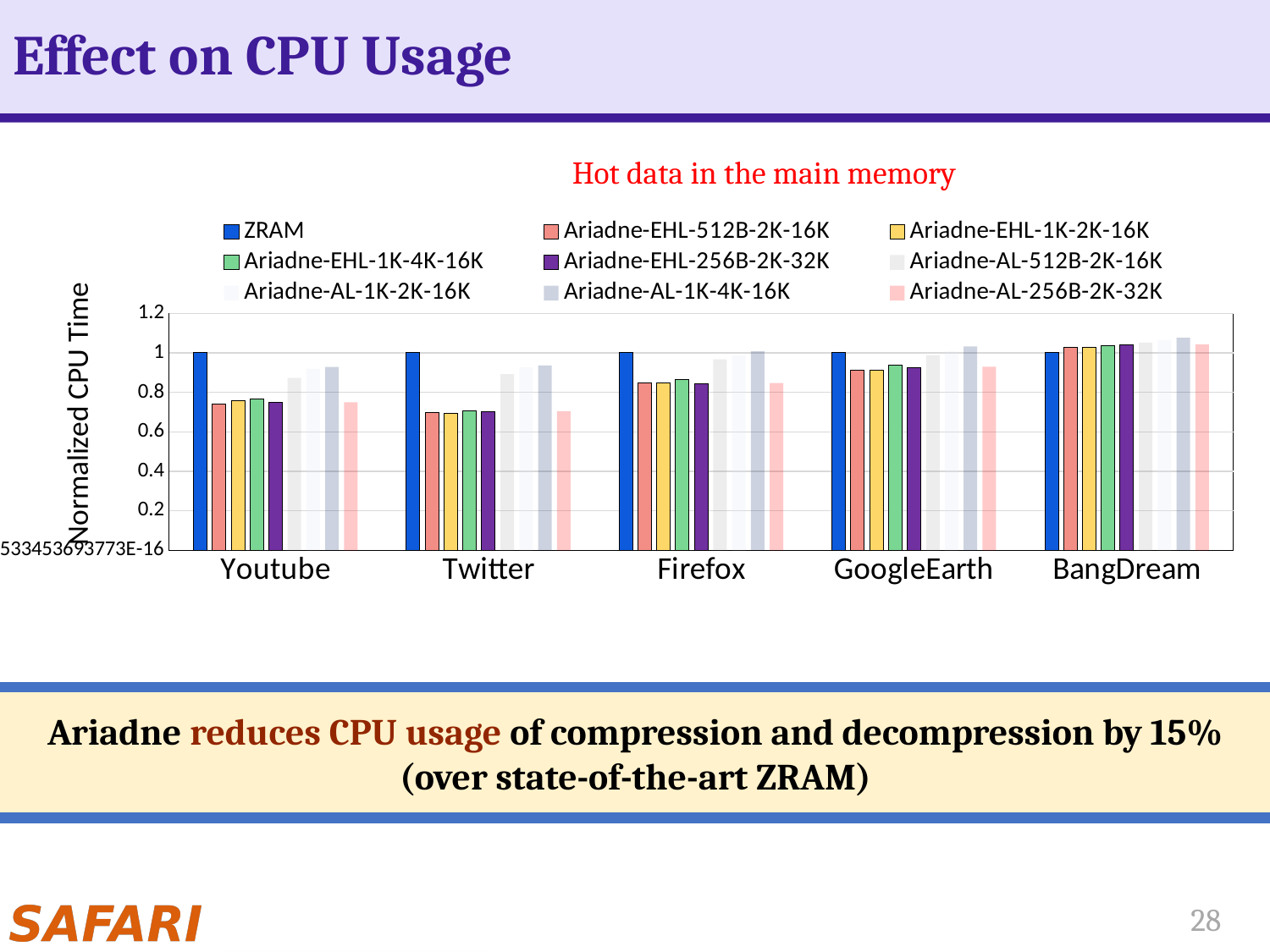
What is the normalized CPU time of ZRAM for Youtube? 1 What is the normalized CPU time of ZRAM for Firefox? 1 What kind of chart is shown on the slide? bar chart What is the label of the y axis? Normalized CPU Time For Twitter, which series has the highest normalized CPU time? ZRAM Is the value for Ariadne-AL-256B-2K-32K on GoogleEarth greater or less than 0.8? greater How many series does the legend list? 9 How many application categories are shown on the x axis? 5 Is the value for Ariadne-EHL-512B-2K-16K on Youtube greater or less than 0.8? less For Firefox, which is larger: Ariadne-AL-1K-4K-16K or Ariadne-AL-256B-2K-32K? Ariadne-AL-1K-4K-16K For Youtube, which is larger: ZRAM or Ariadne-EHL-512B-2K-16K? ZRAM Is the value for Ariadne-AL-256B-2K-32K on Twitter greater or less than 0.8? less